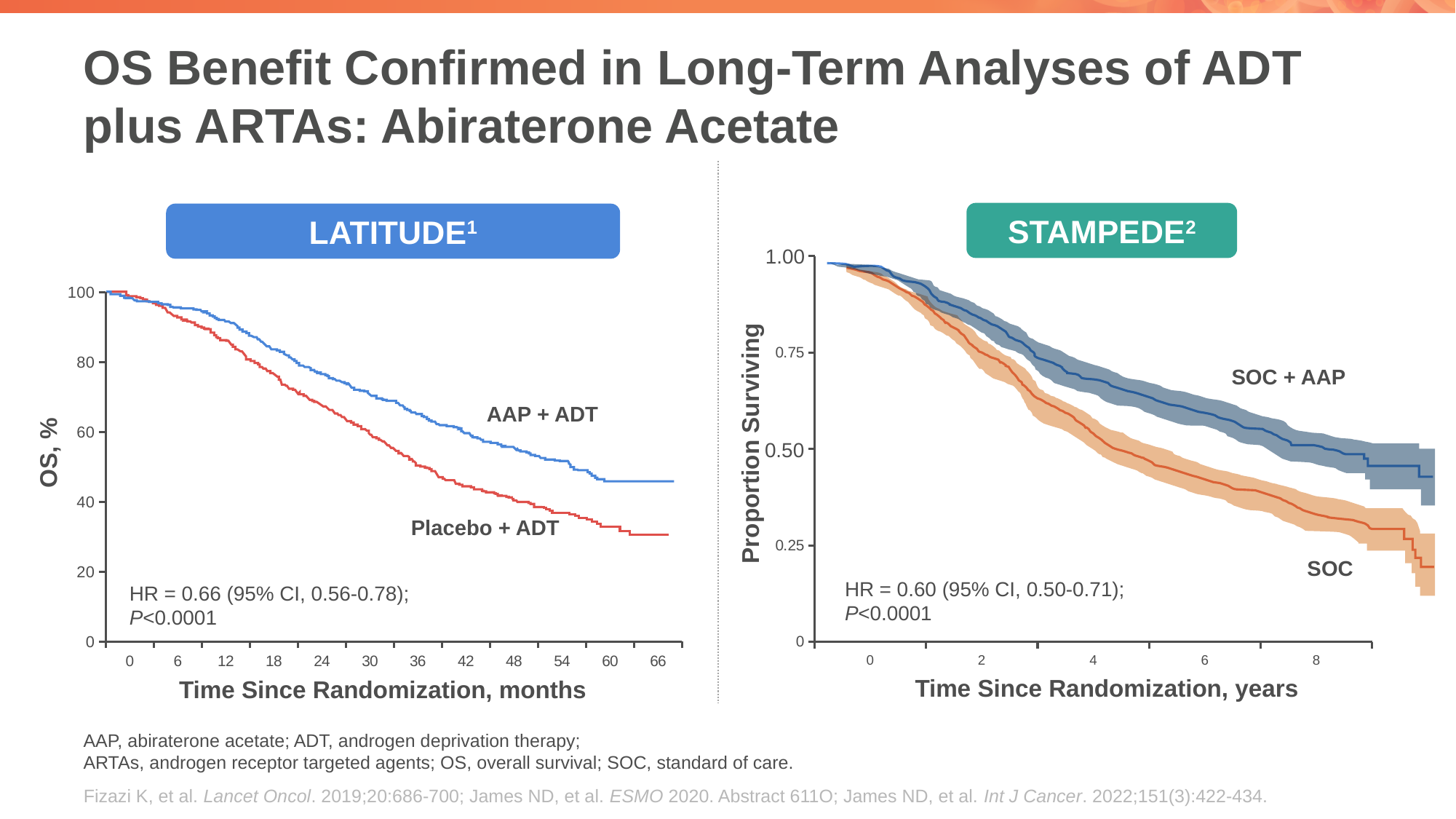
On the LATITUDE chart, is the OS value for AAP + ADT at 36 months greater or less than 60? greater On the STAMPEDE chart, is the proportion surviving for SOC + AAP at 4 years greater or less than 0.50? greater On the LATITUDE chart, is the OS value for Placebo + ADT at 60 months greater or less than 40? less On the STAMPEDE chart, which arm has the lower proportion surviving at 8 years, SOC + AAP or SOC? SOC What hazard ratio is reported on the STAMPEDE chart? HR = 0.60 (95% CI, 0.50-0.71) On the LATITUDE chart, do the OS values rise or fall as time since randomization increases? fall On the STAMPEDE chart, does the proportion surviving rise or fall over time since randomization? fall How many curves (series) are plotted on the LATITUDE chart? 2 How many curves (series) are plotted on the STAMPEDE chart? 2 What kind of chart is the LATITUDE chart on the left? line chart On the LATITUDE chart, which arm has the higher OS at 48 months, AAP + ADT or Placebo + ADT? AAP + ADT